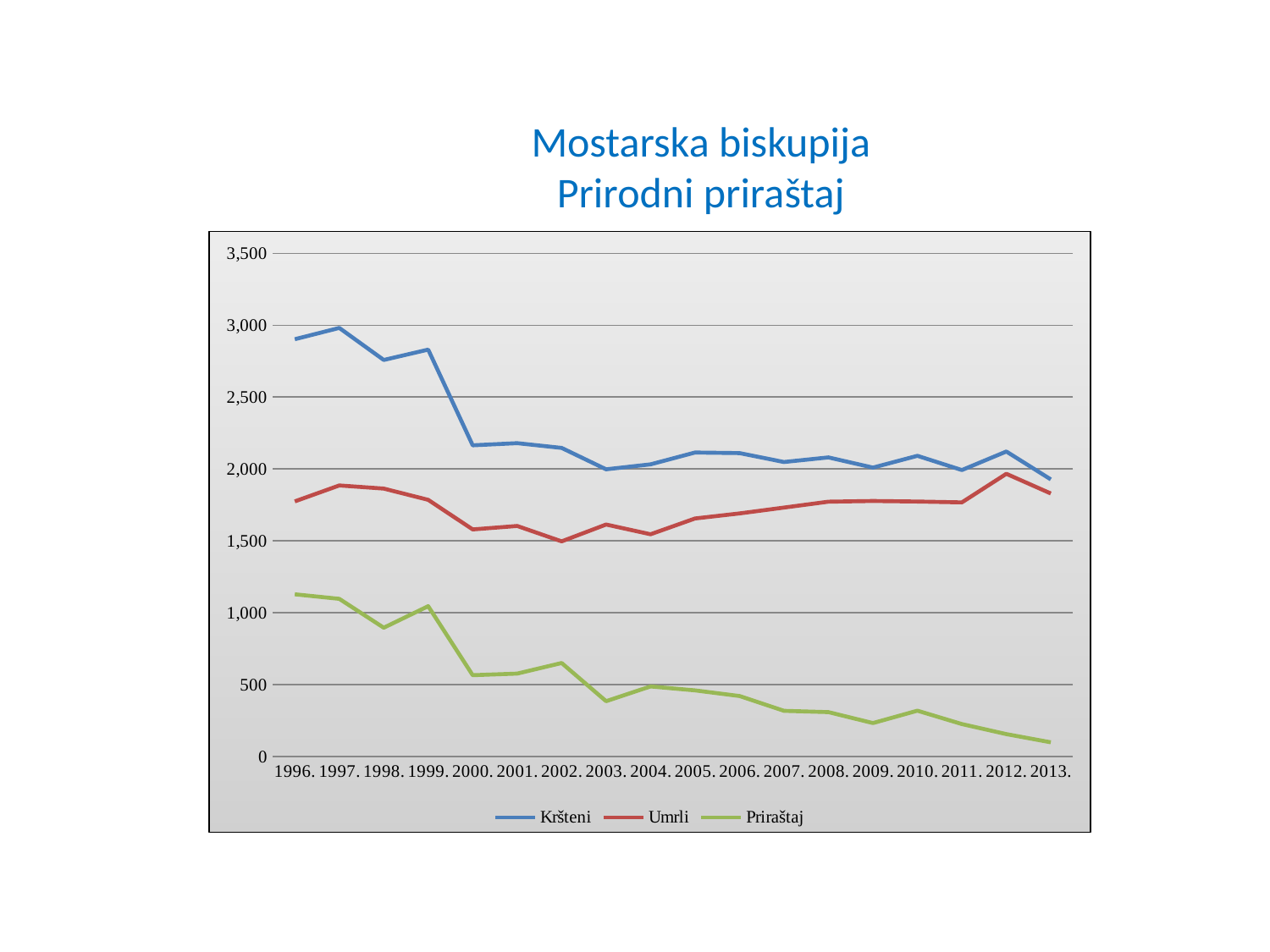
In which year is the Umrli series at its highest? 2012. How many series does the legend list? 3 How many years are plotted along the x axis? 18 In which year is the Kršteni series at its highest? 1997. In which year is the Priraštaj series at its lowest? 2013. What colour is the line for the Umrli series? red Does the Priraštaj series generally rise or fall from 1996 to 2013? fall Is the value for Kršteni in 1996 greater or less than 2,500? greater What kind of chart is shown on the slide? line chart Which is larger for Priraštaj: the value in 1999 or the value in 2000? 1999. Is the value for Priraštaj in 2013 greater or less than 500? less